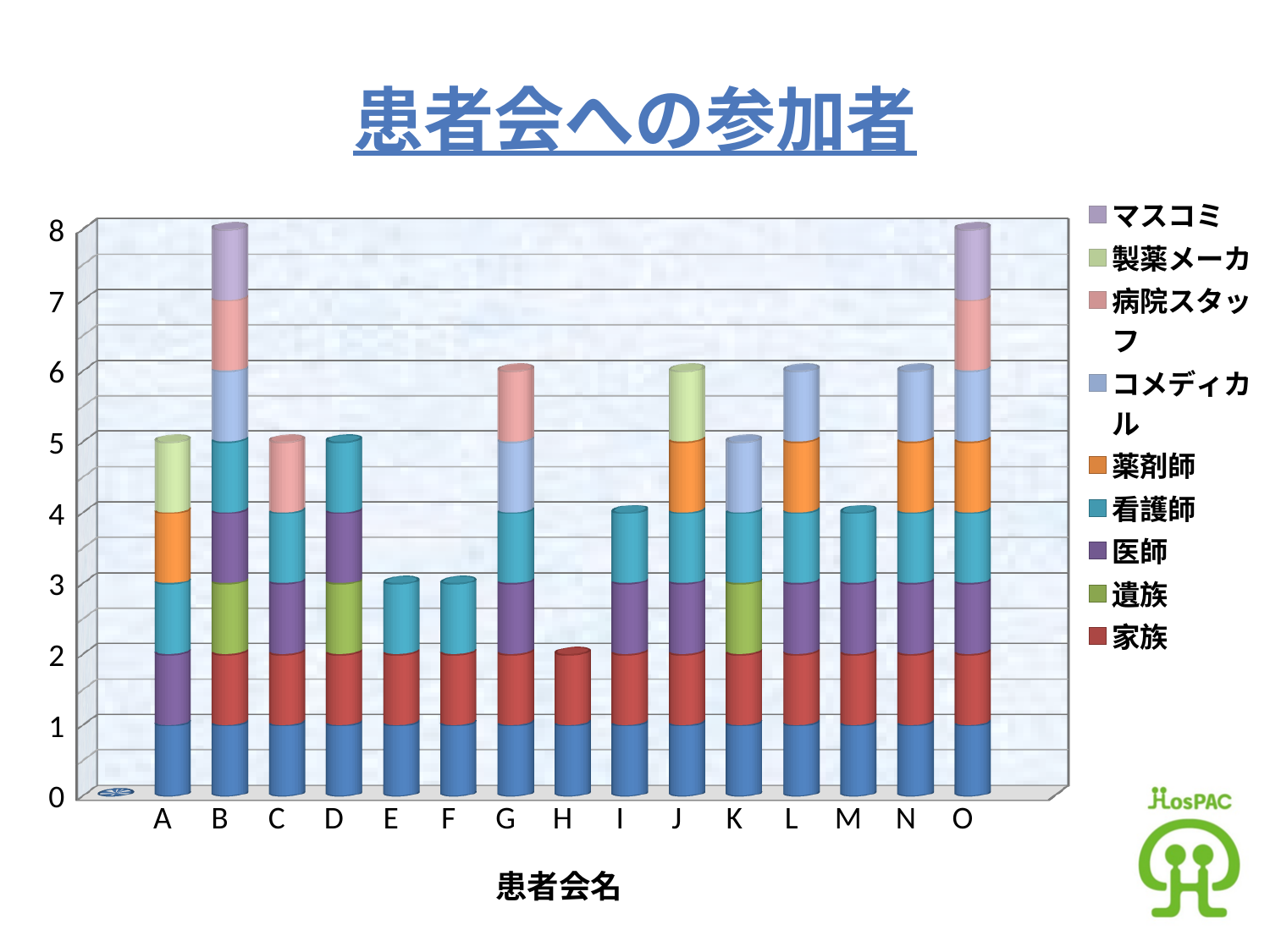
What kind of chart is shown on the slide? Stacked bar chart Which has a larger total, patient group I or patient group J? J How many series does the legend list? 9 What is the title of the chart? 患者会への参加者 What is the x-axis title of the chart? 患者会名 What is the total height of the stacked bar for patient group H? 2 How many patient groups (categories) are shown on the x axis? 15 Which patient group has the lowest total number of participants? H What is the difference between the total for patient group B and the total for patient group E? 5 What is the total height of the stacked bar for patient group B? 8 Which has a larger total, patient group G or patient group E? G Is the total for patient group L greater or less than 5? greater